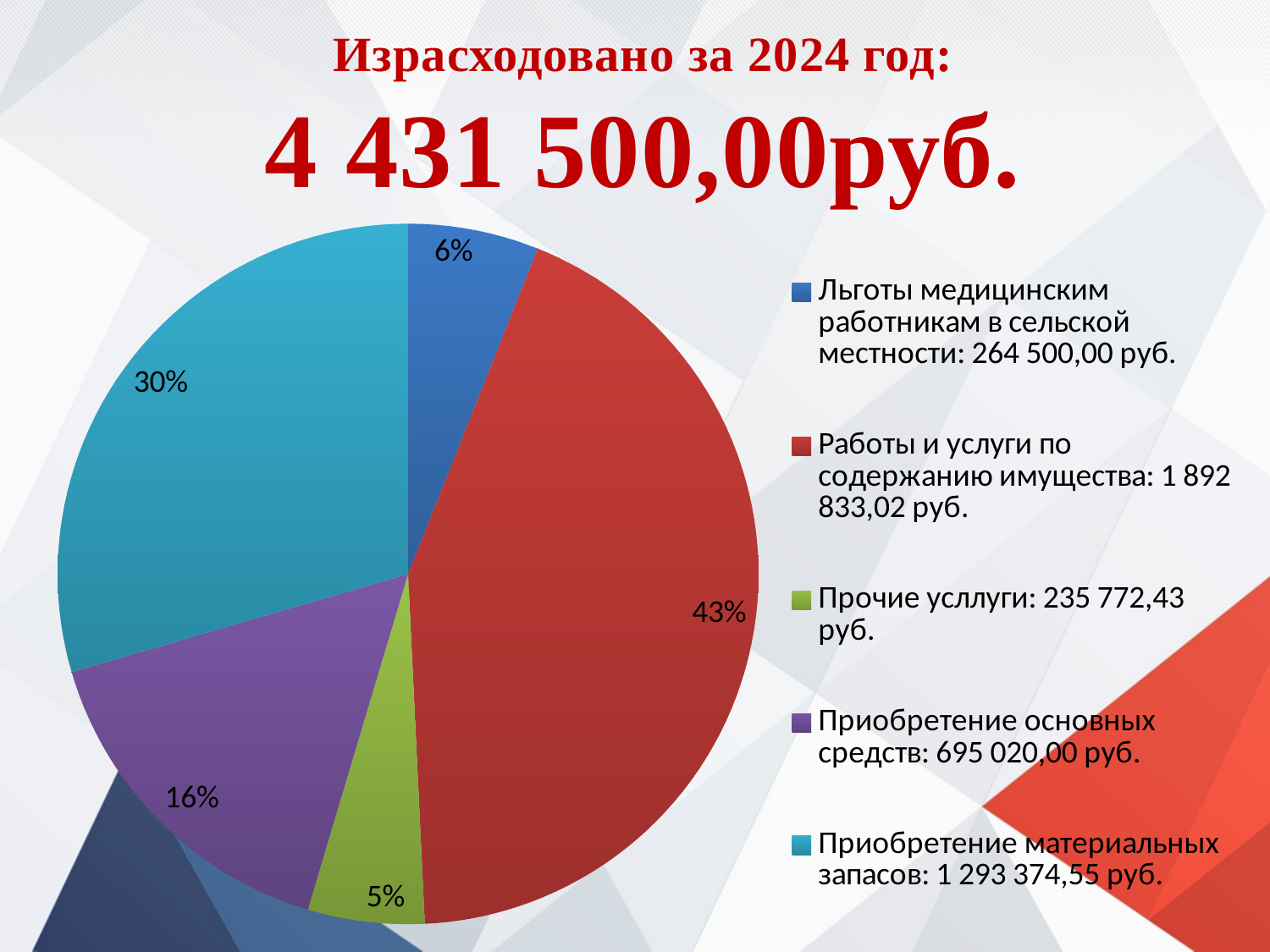
What percentage share does the slice for "Приобретение основных средств" have? 16% Which category has the largest slice of the pie chart? Работы и услуги по содержанию имущества Which category has the smallest slice of the pie chart? Прочие услуги What percentage share does the slice for "Приобретение материальных запасов" have? 30% What total amount spent in 2024 is stated in the slide title? 4 431 500,00руб. What percentage share does the slice for "Прочие услуги" have? 5% What is the difference in percentage points between the slices for "Работы и услуги по содержанию имущества" and "Приобретение материальных запасов"? 13% How many slices does the pie chart have? 5 What kind of chart is shown on the slide? pie chart How many entries does the legend of the pie chart list? 5